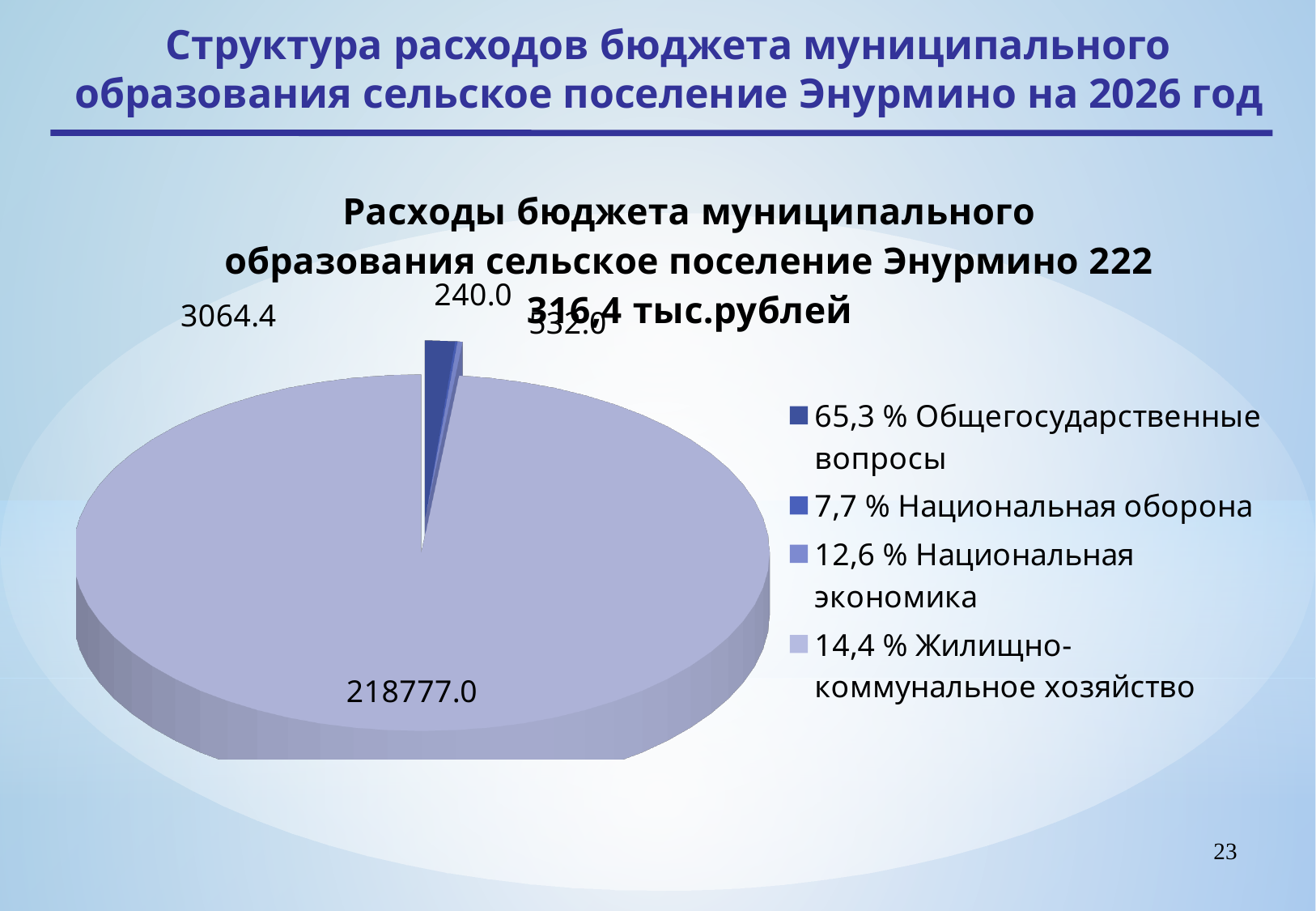
What is the smallest data label shown on the pie chart? 240.0 What is the largest data label shown on the pie chart? 218777.0 According to the legend, what percentage share is given for Национальная экономика? 12,6 % What kind of chart is shown on the slide? pie chart According to the legend, what percentage share is given for Общегосударственные вопросы? 65,3 % How many entries does the chart legend list? 4 What is the difference between the data labels 3064.4 and 240.0 on the pie chart? 2824.4 Which is larger among the data labels on the pie chart: 3064.4 or 240.0? 3064.4 What total amount in thousand rubles is stated in the chart title? 222 316,4 тыс.рублей According to the legend, what percentage share is given for Национальная оборона? 7,7 % According to the legend, what percentage share is given for Жилищно-коммунальное хозяйство? 14,4 % Which legend entry has the largest percentage share? Общегосударственные вопросы